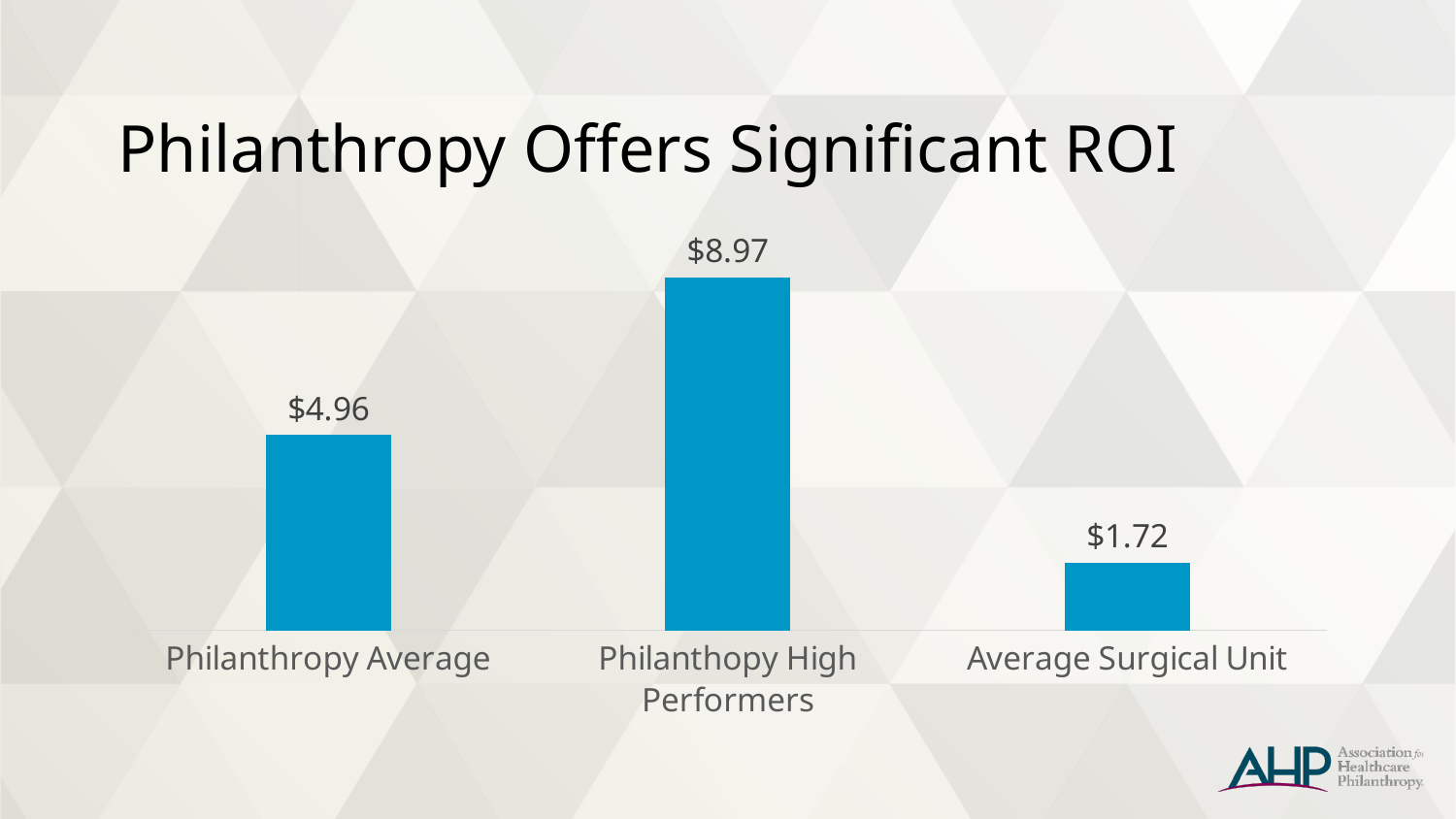
What is the value for Philanthopy High Performers? $8.97 What is the difference between the values for Philanthopy High Performers and Philanthropy Average? $4.01 What kind of chart is shown on the slide? Bar chart What is the difference between the values for Philanthropy Average and Average Surgical Unit? $3.24 Which category has the highest value? Philanthopy High Performers What colour are the bars in the chart? Blue Which category has the lowest value? Average Surgical Unit What is the title of the slide? Philanthropy Offers Significant ROI Which is larger, the value for Philanthropy Average or the value for Average Surgical Unit? Philanthropy Average What is the value for Average Surgical Unit? $1.72 What is the value for Philanthropy Average? $4.96 How many categories are shown in the chart? 3